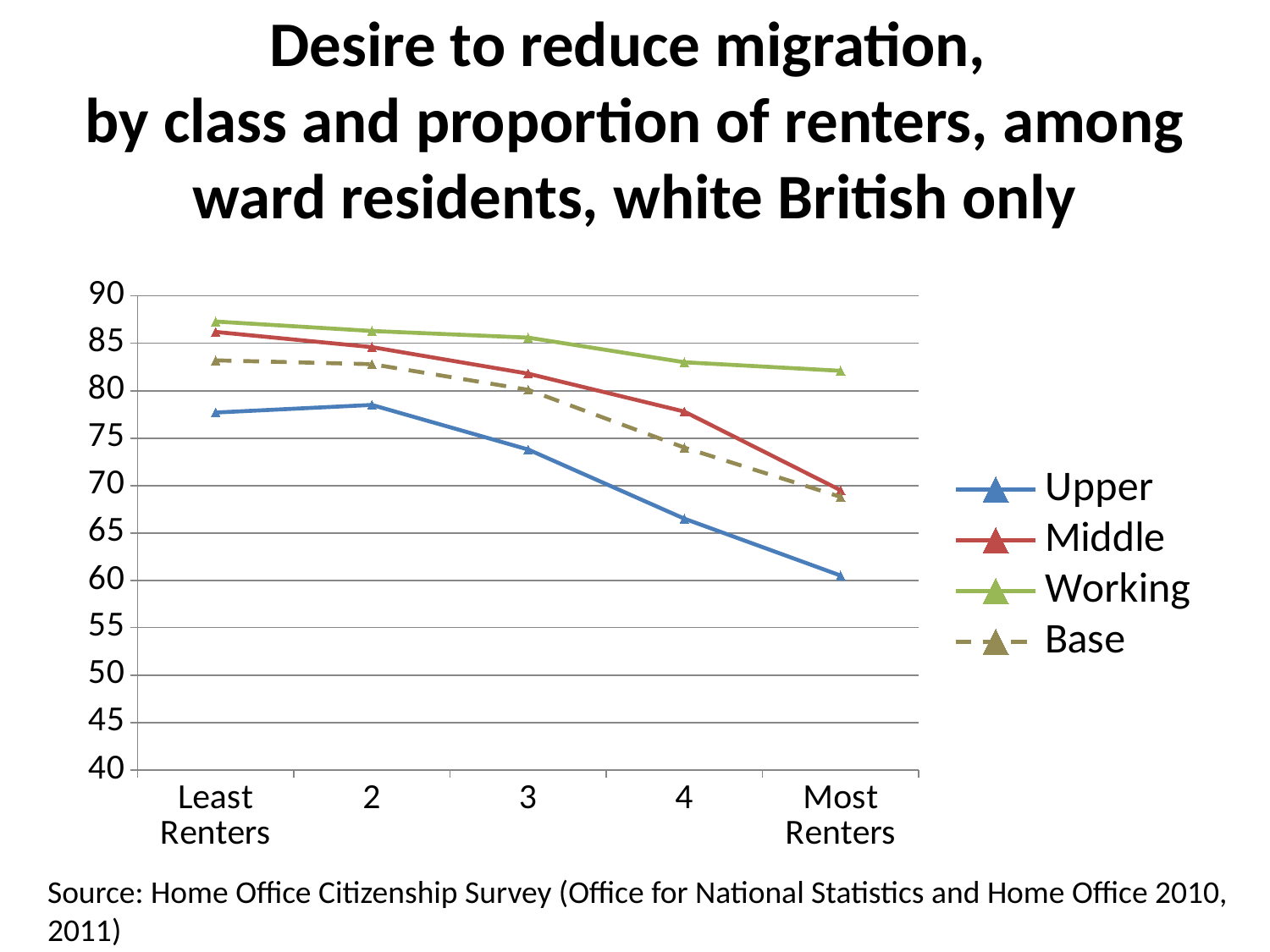
Is the value for Working at Least Renters greater or less than 85? greater Which series has the highest value at Most Renters? Working Does the Upper series generally rise or fall from Least Renters to Most Renters? fall Which series has the lowest value at Most Renters? Upper Is the value for Working at Most Renters greater or less than 80? greater What kind of chart is shown on the slide? line chart Is the value for Middle at category 4 greater or less than 75? greater How many categories are shown along the x axis? 5 How many series does the legend list? 4 Which series is drawn with a dashed line? Base Which is larger at Least Renters, the value for Upper or the value for Base? Base